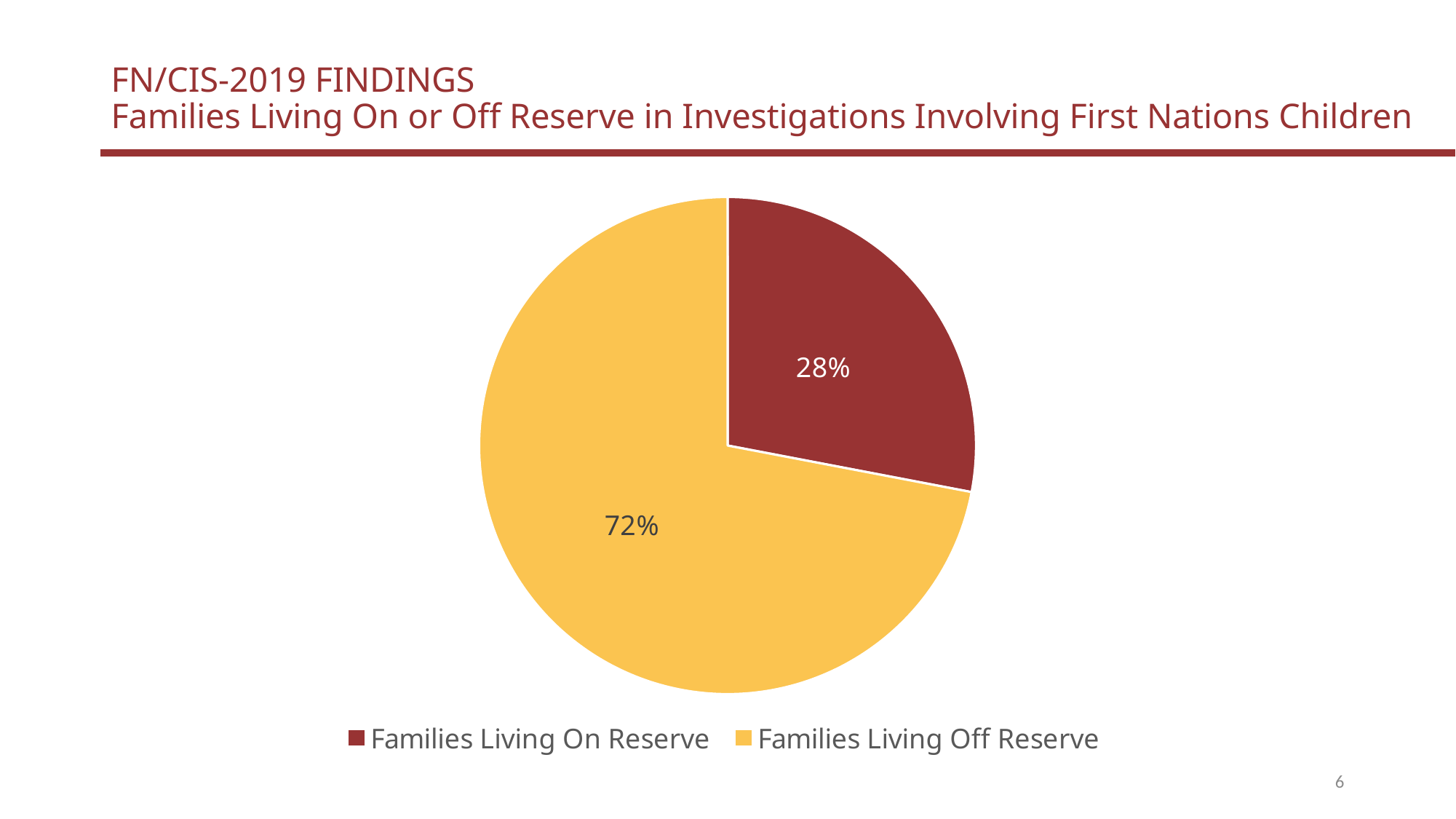
What kind of chart is shown on the slide? Pie chart Which is larger: the share for Families Living On Reserve or Families Living Off Reserve? Families Living Off Reserve What is the difference in percentage points between Families Living Off Reserve and Families Living On Reserve? 44 What share of the pie does the Families Living On Reserve slice represent? 28% Which category has the largest share of the pie chart? Families Living Off Reserve What colour is the slice for Families Living Off Reserve? Yellow Which category has the smallest share of the pie chart? Families Living On Reserve What percentage of the pie chart represents Families Living On Reserve? 28% How many slices does the pie chart have? 2 What colour is the slice for Families Living On Reserve? Dark red How many entries does the legend list? 2 What percentage of the pie chart represents Families Living Off Reserve? 72%